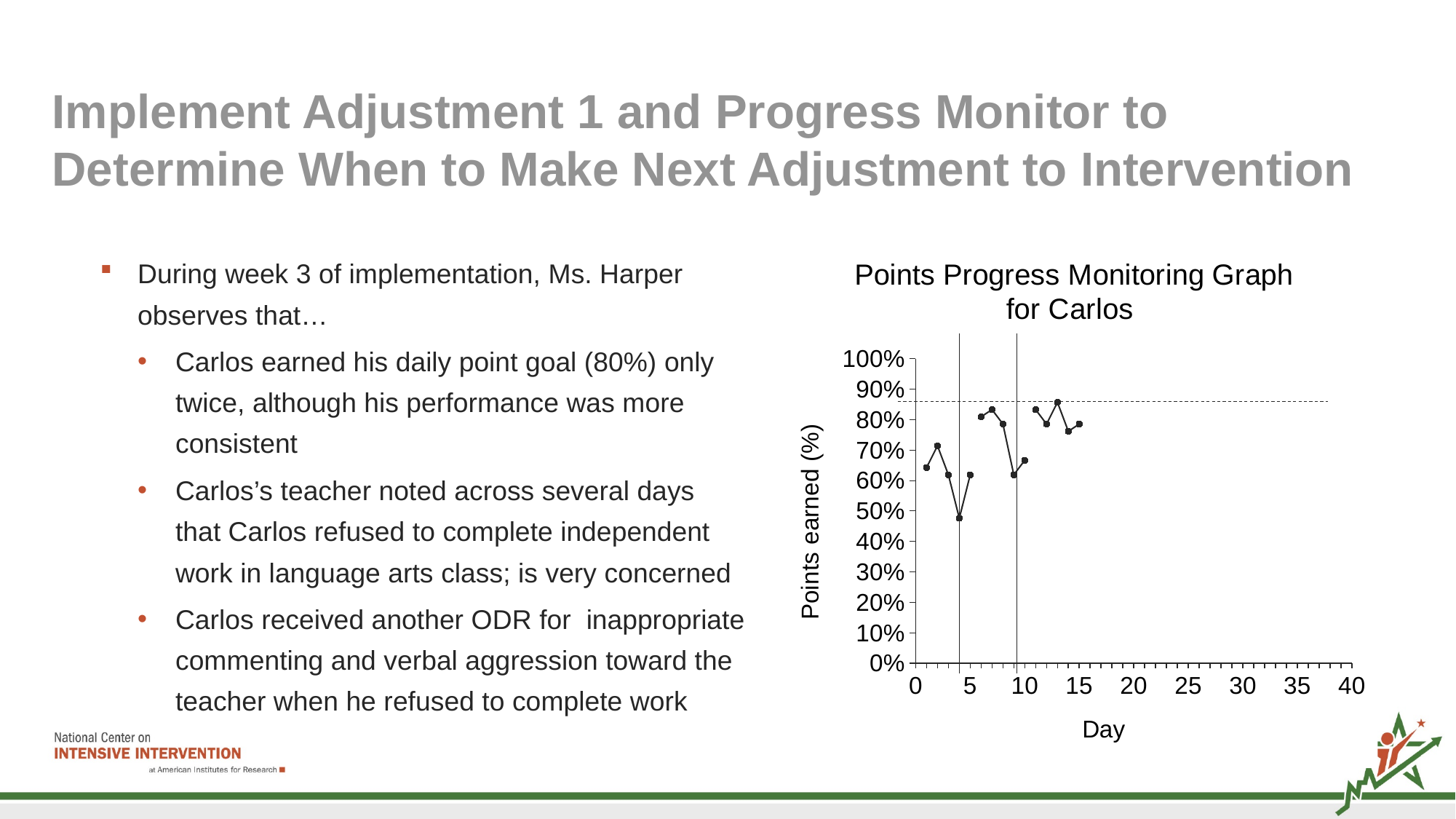
Is the value for Day 4 greater or less than 60%? less Is the value for Day 13 greater or less than 80%? greater Do the values rise or fall from Day 2 to Day 4? fall Is the value for Day 9 greater or less than 70%? less On which day is the lowest value plotted? Day 4 How many data points are plotted on the chart? 15 Do the values rise or fall from Day 4 to Day 7? rise What kind of chart is shown on the slide? line chart What is the title of the chart? Points Progress Monitoring Graph for Carlos Which is larger, the value for Day 4 or the value for Day 13? Day 13 What is the label of the vertical axis of the chart? Points earned (%)